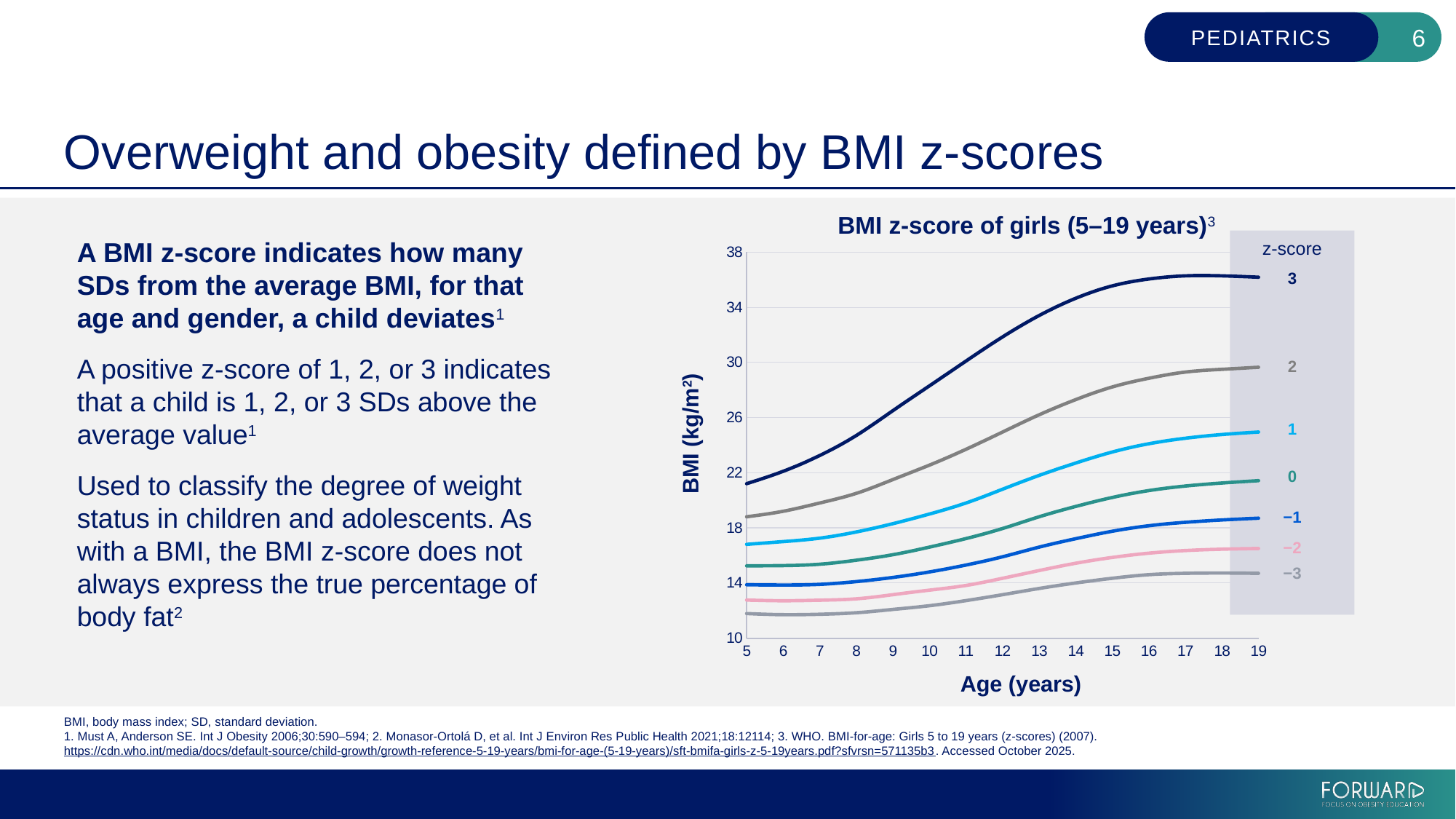
What is the title of the chart? BMI z-score of girls (5–19 years) At age 19, which line has the larger BMI value: z-score 2 or z-score 0? z-score 2 Does the BMI for the z-score 3 line rise or fall as age increases from 5 to 19 years? rise Which z-score line is lowest on the chart? –3 What kind of chart is shown on the slide? line chart Is the BMI value for the z-score 3 line at age 19 greater or less than 34? greater How many age values are marked on the x axis of the chart? 15 Which z-score line is highest on the chart? 3 How many z-score lines does the chart show? 7 Is the BMI value for the z-score 1 line at age 19 greater or less than 22? greater Is the BMI value for the z-score –3 line at age 5 greater or less than 14? less What is the label of the y axis of the chart? BMI (kg/m²)